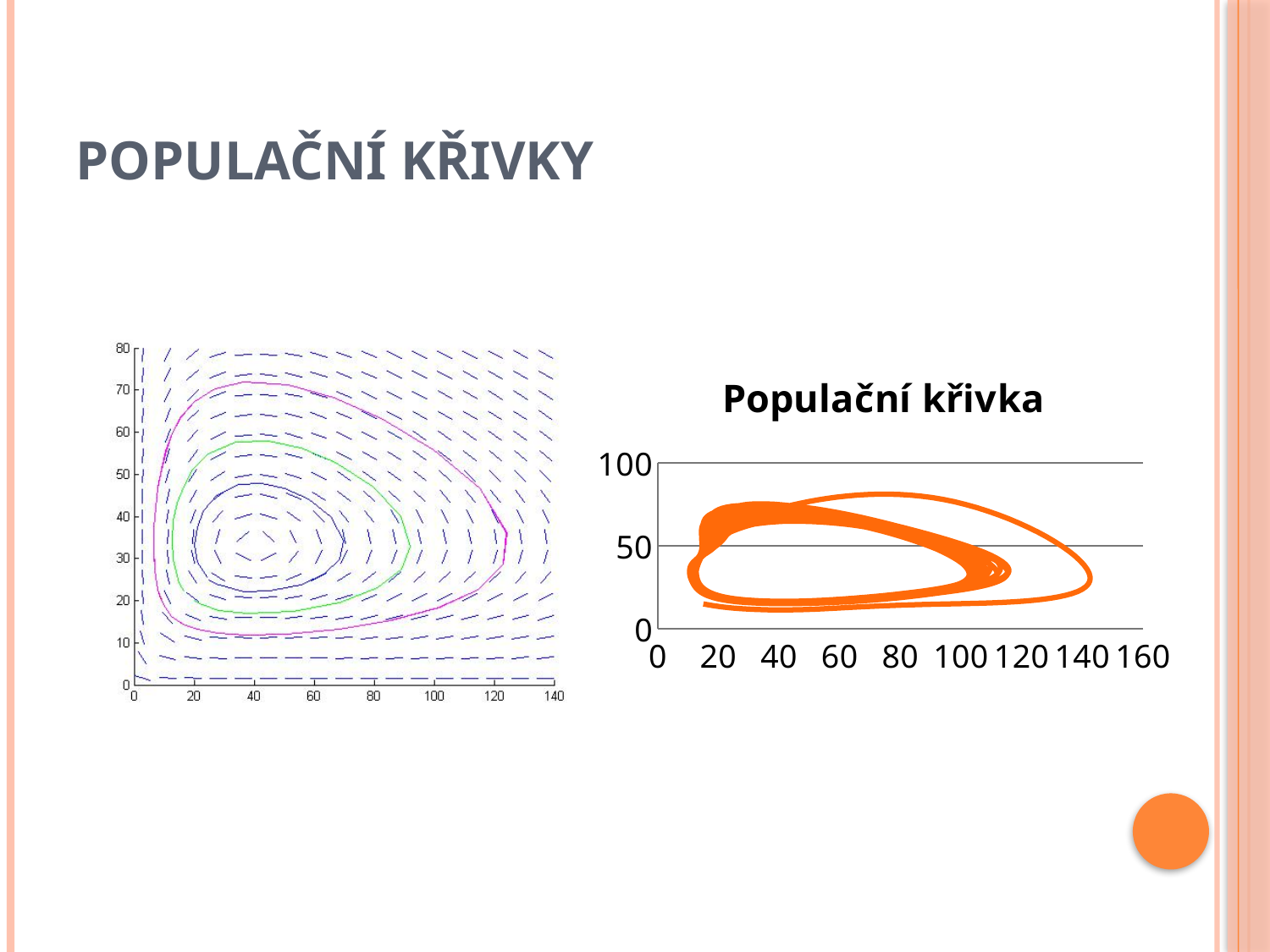
What kind of chart is the chart on the right titled "Populační křivka"? line chart (curve plot) In the chart on the right titled "Populační křivka", is the highest point of the orange curve greater or less than 100 on the vertical axis? less How many closed orbit curves are drawn in the chart on the left side of the slide? 3 In the chart on the right titled "Populační křivka", is the rightmost point of the orange curve greater or less than 160 on the horizontal axis? less In the chart on the right titled "Populační křivka", is the highest point of the orange curve greater or less than 50 on the vertical axis? greater In the chart on the left side of the slide, which closed curve is larger, the green one or the blue one? the green one In the chart on the right titled "Populační křivka", what is the largest value shown on the horizontal axis? 160 What is the title of the chart on the right side of the slide? Populační křivka